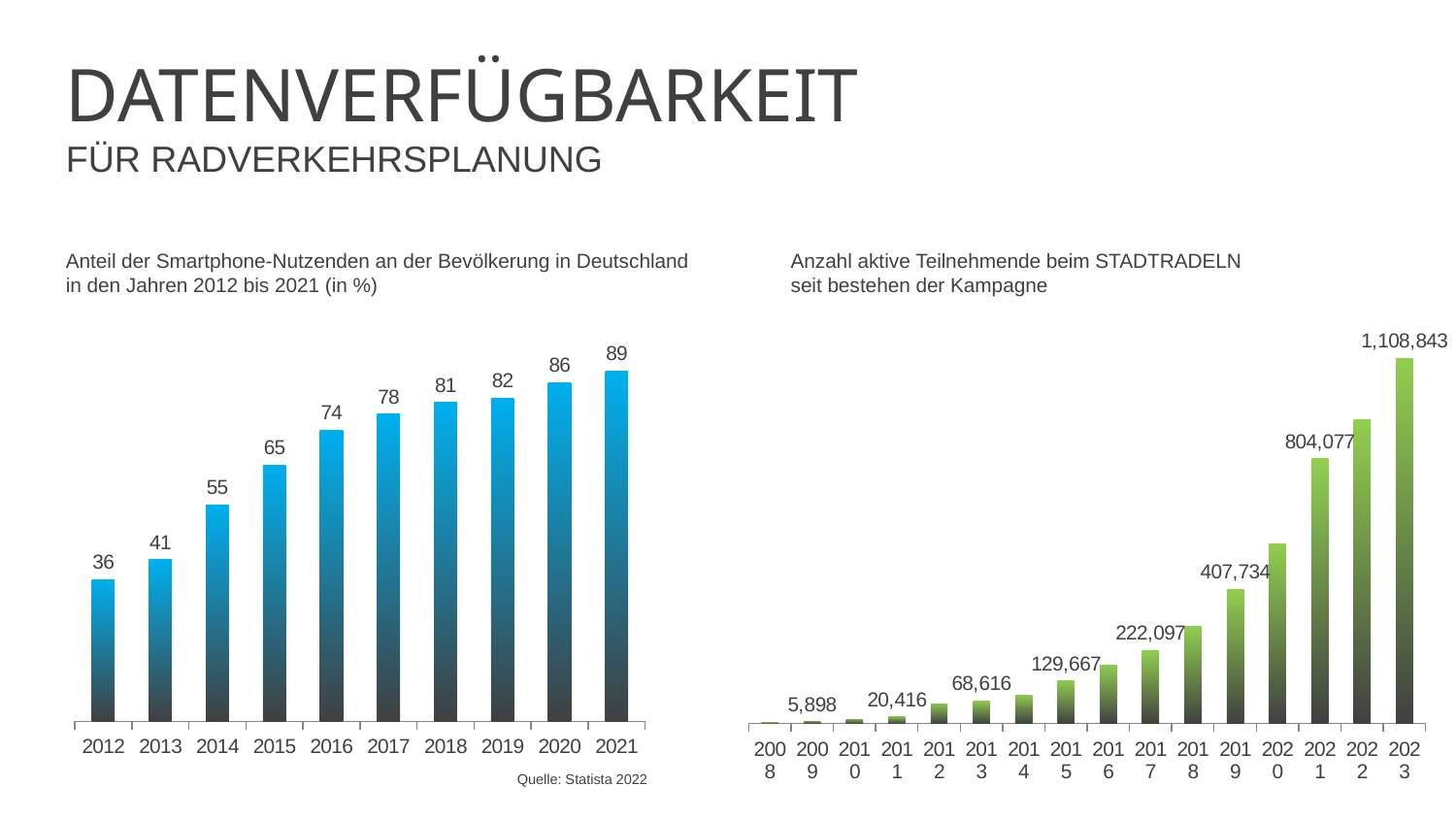
What kind of chart is the right chart (Anzahl aktive Teilnehmende beim STADTRADELN)? bar chart In the left chart (Anteil der Smartphone-Nutzenden), how many years are shown on the x axis? 10 In the right chart (Anzahl aktive Teilnehmende beim STADTRADELN), what is the value for 2023? 1,108,843 In the left chart (Anteil der Smartphone-Nutzenden), do the values rise or fall from 2012 to 2021? rise In the left chart (Anteil der Smartphone-Nutzenden), what is the value for 2017? 78 In the left chart (Anteil der Smartphone-Nutzenden), which year has the highest value? 2021 In the left chart (Anteil der Smartphone-Nutzenden), what is the value for 2012? 36 In the left chart (Anteil der Smartphone-Nutzenden), which year has the lowest value? 2012 In the right chart (Anzahl aktive Teilnehmende beim STADTRADELN), how many years are shown on the x axis? 16 In the right chart (Anzahl aktive Teilnehmende beim STADTRADELN), which year has the highest value? 2023 In the left chart (Anteil der Smartphone-Nutzenden), what is the difference between the values for 2021 and 2012? 53 In the right chart (Anzahl aktive Teilnehmende beim STADTRADELN), what is the value for 2021? 804,077